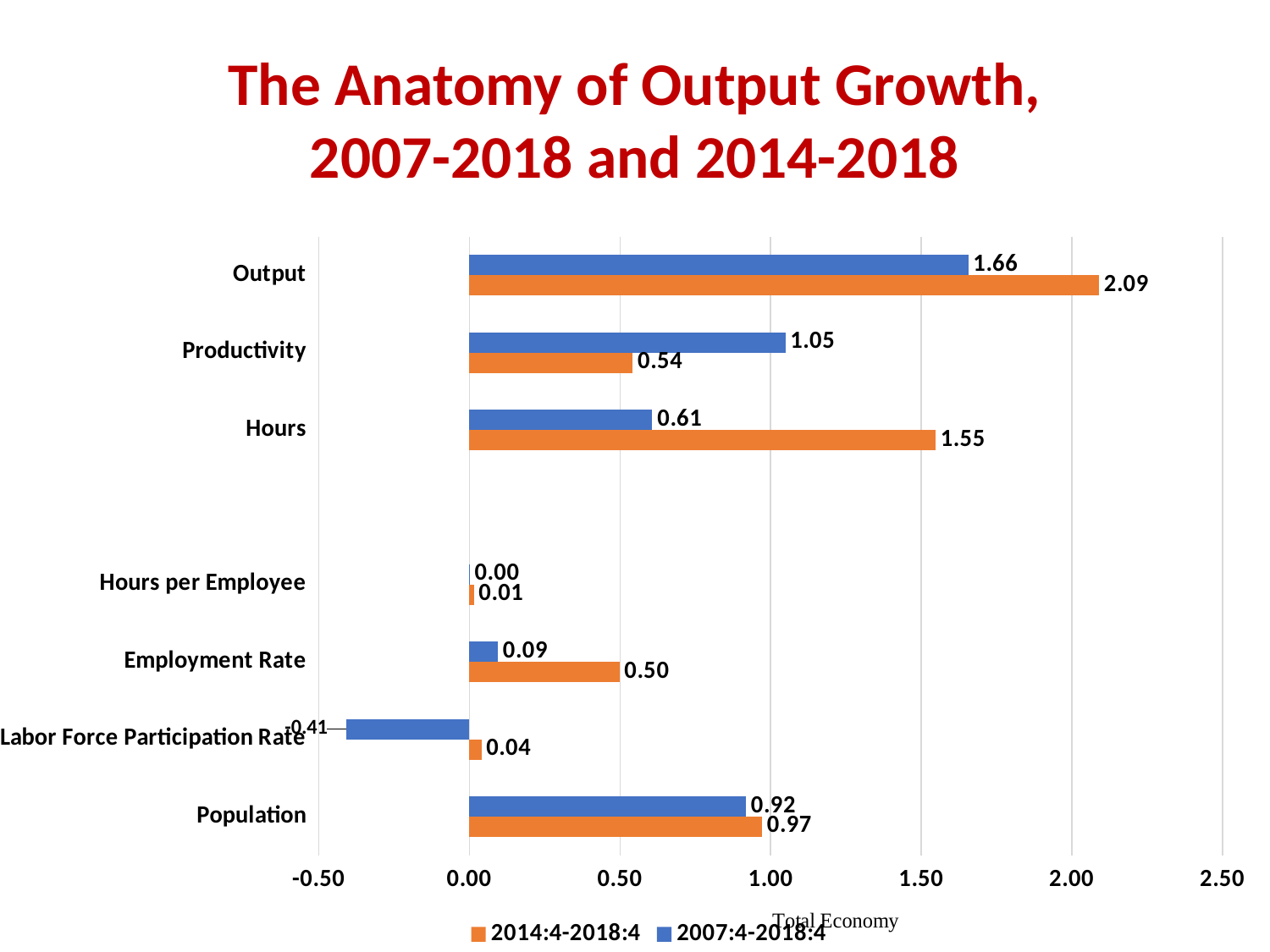
What is the value for Labor Force Participation Rate in the 2007:4-2018:4 series? -0.41 What is the value for Productivity in the 2007:4-2018:4 series? 1.05 Which category has the lowest value in the 2007:4-2018:4 series? Labor Force Participation Rate How many series does the legend list? 2 What kind of chart is shown on the slide? Bar chart Which category has the highest value in the 2014:4-2018:4 series? Output What is the value for Output in the 2014:4-2018:4 series? 2.09 For Productivity, which series has the larger value: 2014:4-2018:4 or 2007:4-2018:4? 2007:4-2018:4 What is the value for Employment Rate in the 2014:4-2018:4 series? 0.50 What is the difference between the 2014:4-2018:4 and 2007:4-2018:4 values for Hours? 0.94 How many categories are shown on the chart? 7 Is the value for Population in the 2007:4-2018:4 series greater or less than 1.00? less